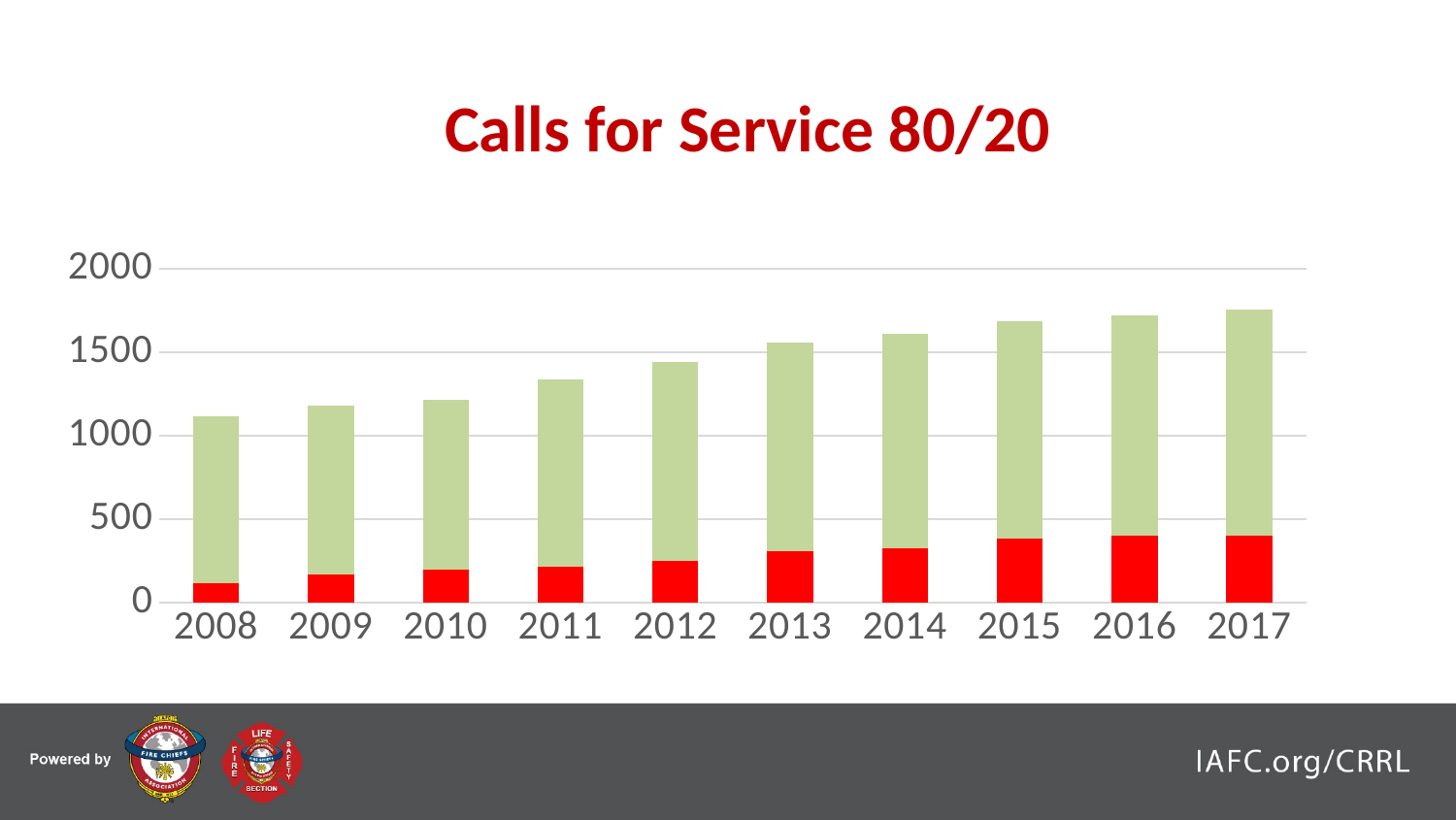
Is the total bar height for 2017 greater or less than 2000? less Is the total bar height for 2017 greater or less than 1500? greater Is the total bar height for 2008 greater or less than 1000? greater How many years are shown along the x axis of the chart? 10 Which year has the tallest bar in the chart? 2017 Do the bar totals rise or fall from 2008 to 2017? Rise Which bar is taller, 2008 or 2017? 2017 Which year has the shortest bar in the chart? 2008 What is the title of the chart? Calls for Service 80/20 What kind of chart is shown on the slide? Bar chart